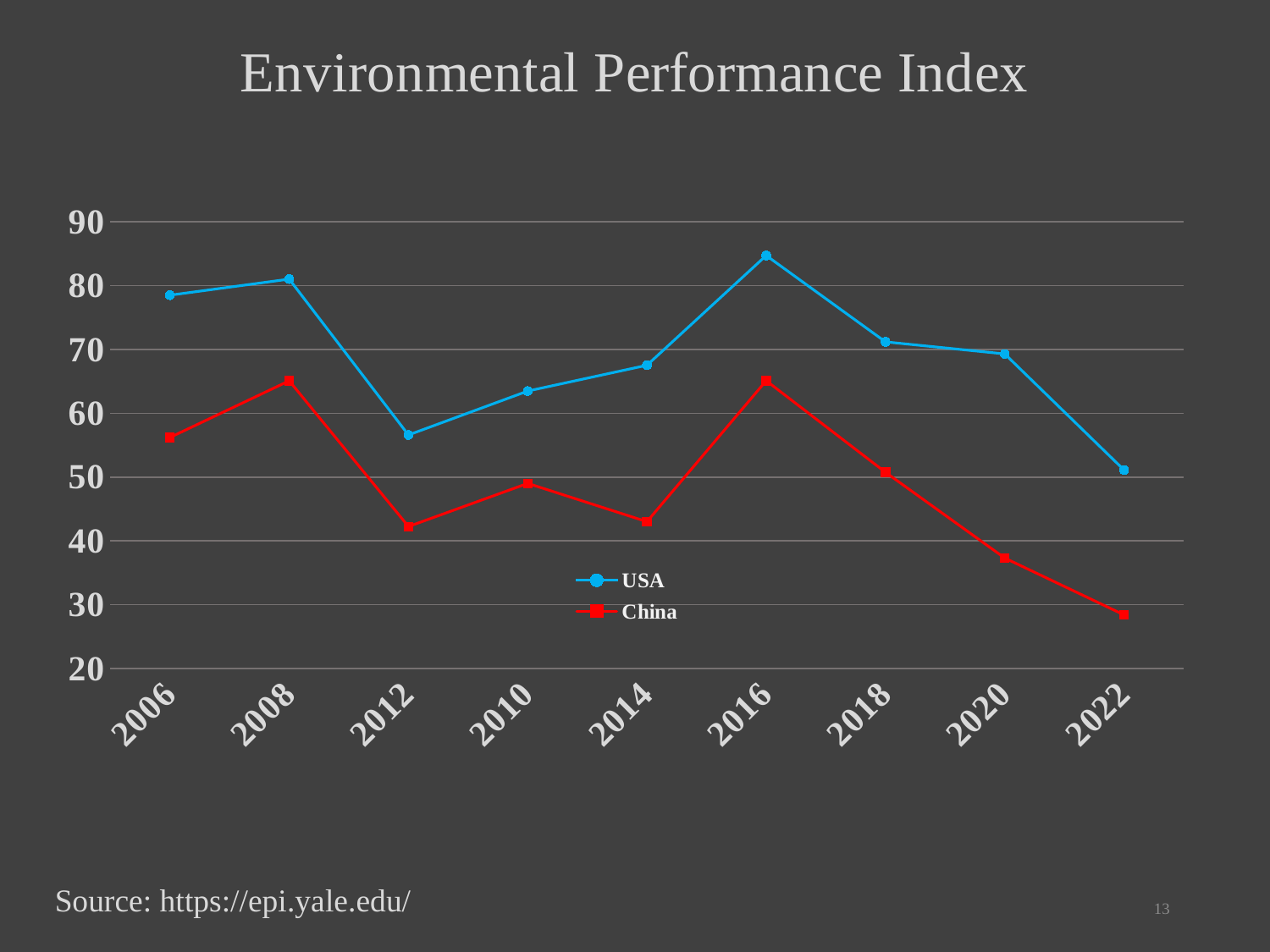
Is the value for China in 2020 greater or less than 40? less How many series does the legend list? 2 How many years are plotted along the x axis? 9 In which year does the China series reach its lowest value? 2022 In which year does the USA series reach its highest value? 2016 Which series has the larger value in 2016, USA or China? USA What kind of chart is shown on the slide? line chart Is the value for USA in 2012 greater or less than 60? less Is the value for USA in 2016 greater or less than 80? greater Do the USA values rise or fall from 2016 to 2022? fall In which year does the USA series reach its lowest value? 2022